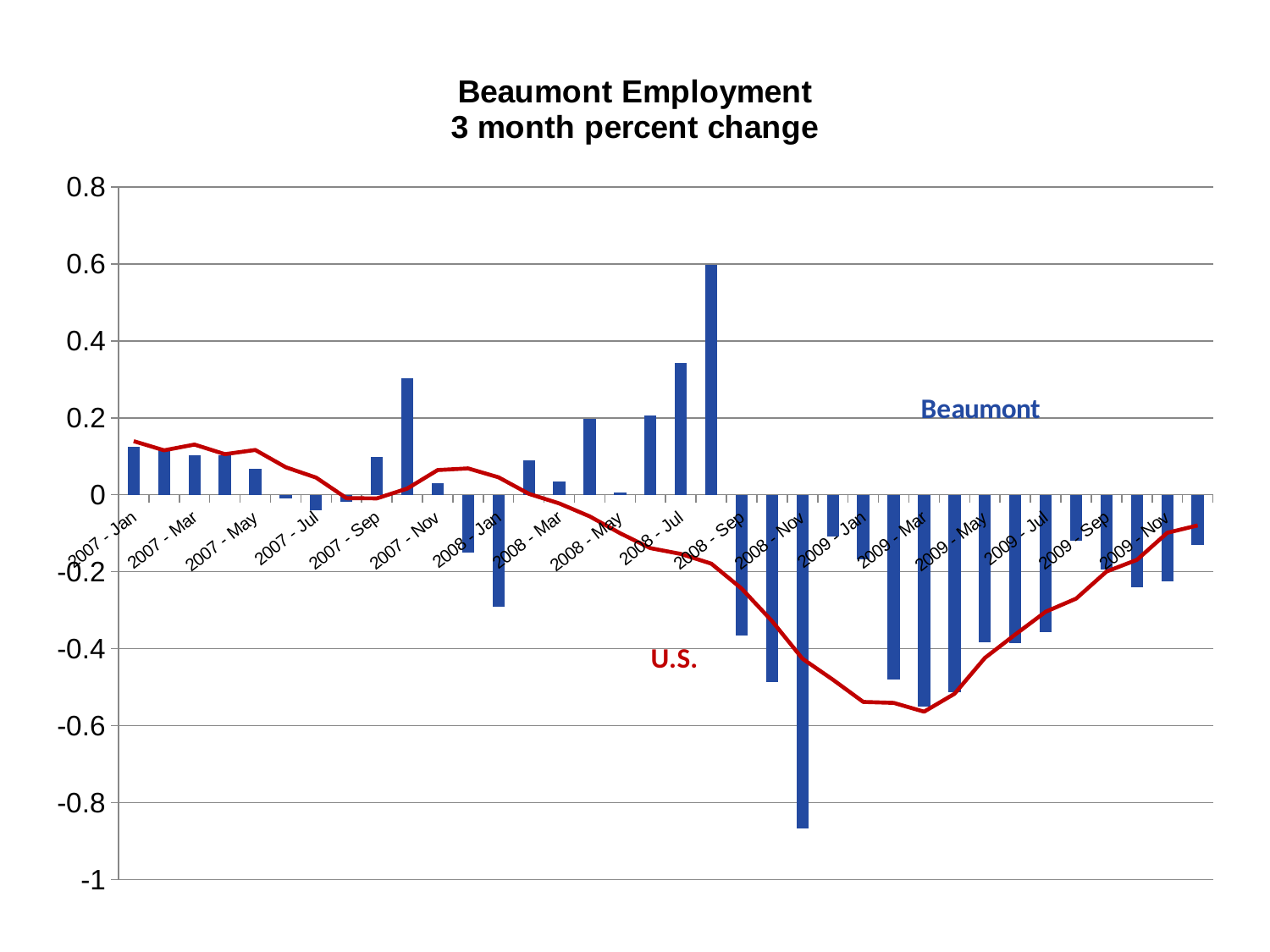
Does the U.S. line rise or fall between 2008 - Sep and 2009 - Mar? fall What is the title of the chart? Beaumont Employment 3 month percent change At 2008 - Nov, which is lower, the Beaumont bar or the U.S. line? Beaumont bar Does the U.S. line rise or fall between 2009 - Mar and 2009 - Nov? rise Is the Beaumont value for 2007 - Jan greater or less than 0? greater What kind of chart is used to show the Beaumont series? bar chart Which month has the lowest Beaumont bar? 2008 - Nov Is the Beaumont value for 2009 - Mar greater or less than -0.4? less Which is lower, the Beaumont bar for 2008 - Nov or the Beaumont bar for 2009 - Mar? 2008 - Nov How many series are shown on the chart? 2 Is the Beaumont value for 2008 - Sep greater or less than -0.2? less